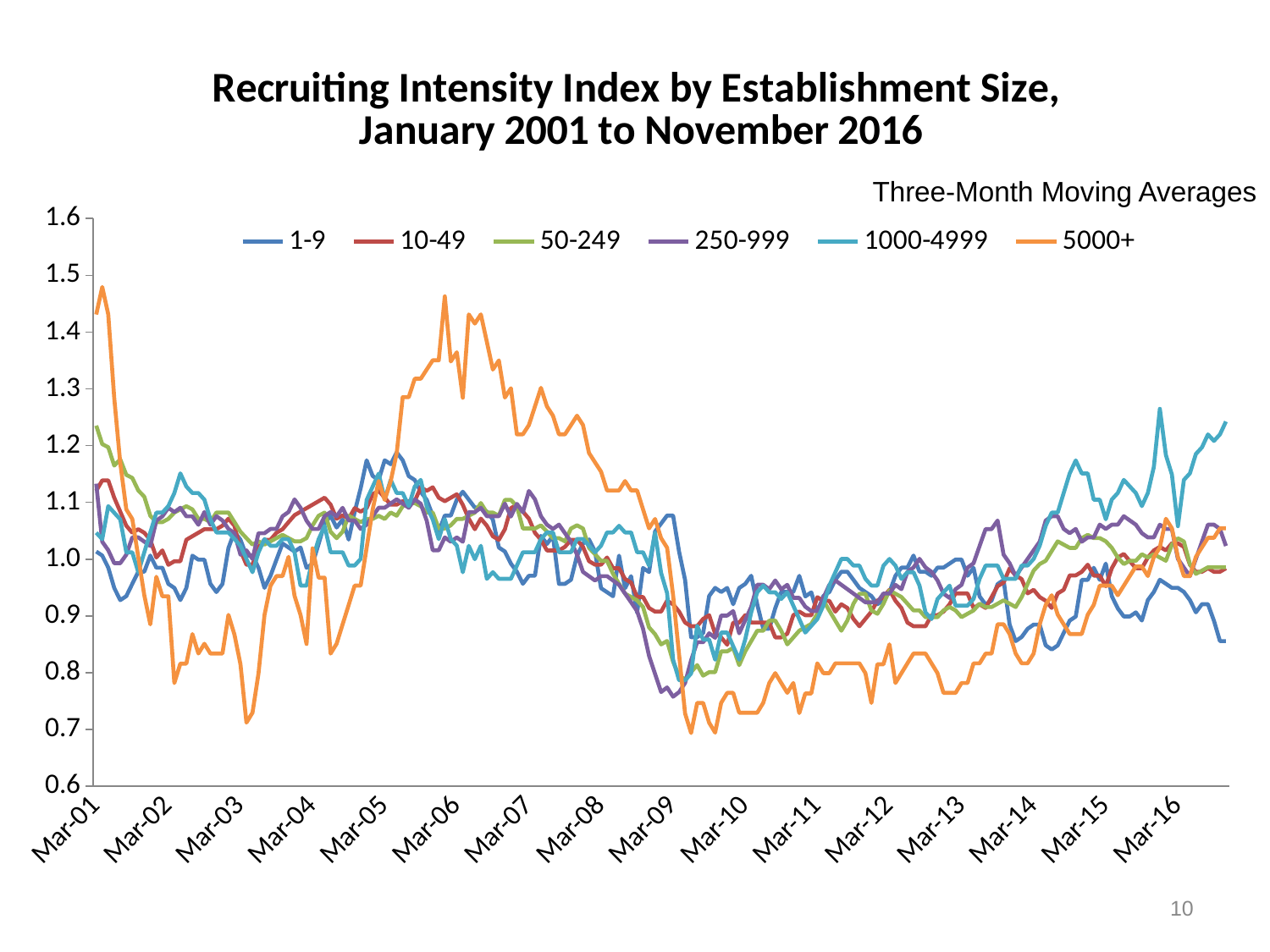
What kind of chart is shown on the slide? Line chart What note appears above the chart's legend, at the top right? Three-Month Moving Averages At the right-hand end of the chart, is the value for the 1-9 series greater or less than 0.9? less Does the 5000+ series rise or fall between Mar-06 and Mar-10? Fall Which establishment-size series reaches the lowest value anywhere on the chart? 5000+ Around Mar-06, is the value for the 5000+ series greater or less than 1.3? greater Which series has the lowest value at the right-hand end of the chart (late 2016)? 1-9 Around Mar-10, is the value for the 5000+ series greater or less than 0.8? less Which establishment-size series reaches the highest value anywhere on the chart? 5000+ Which series has the highest value at the right-hand end of the chart (late 2016)? 1000-4999 How many series does the legend list? 6 Around Mar-06, which series is higher: 5000+ or 1-9? 5000+